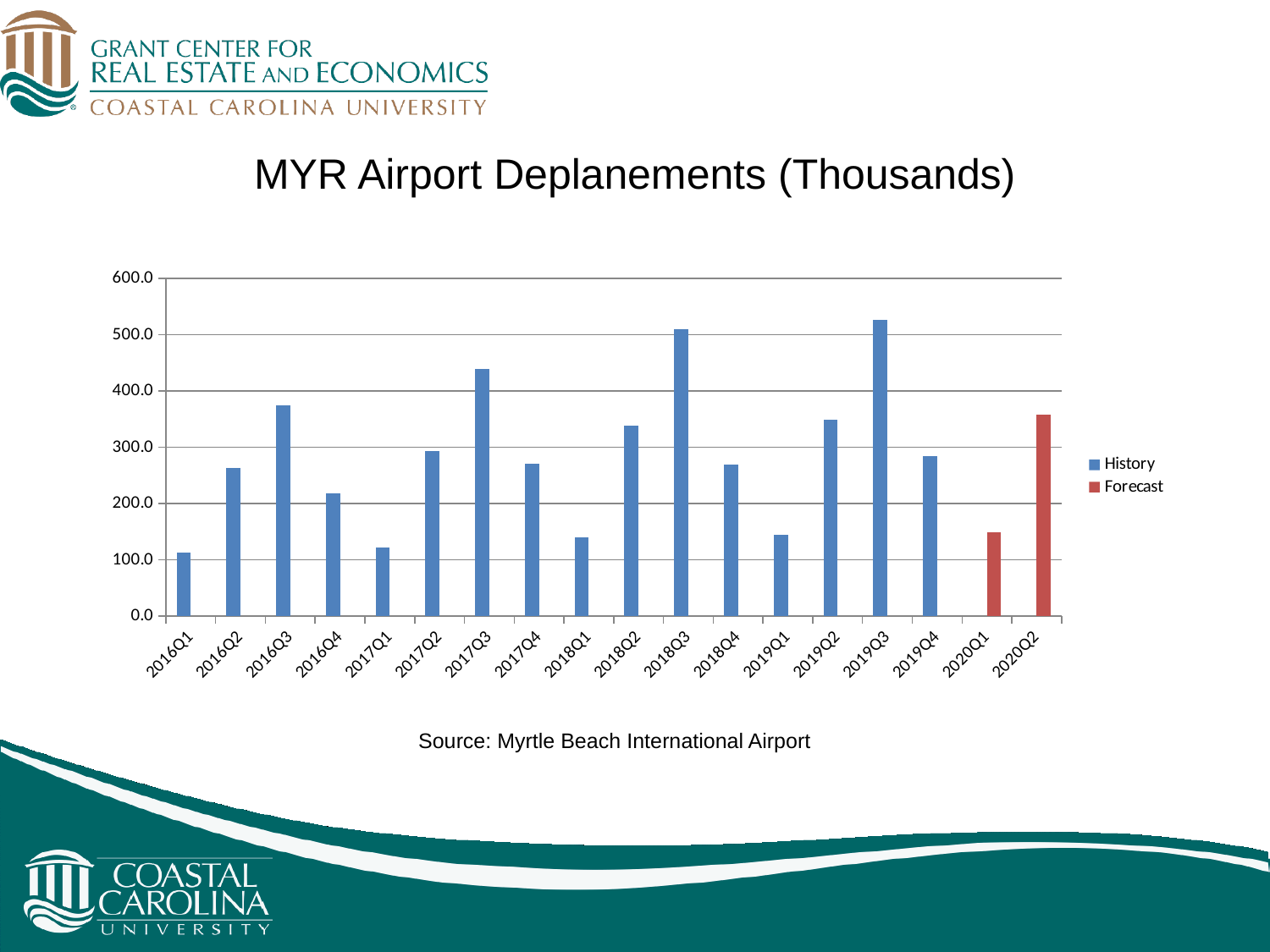
Is the value for 2017Q3 greater or less than 400.0? greater Is the value for 2020Q1 greater or less than 200.0? less What is the title of the chart? MYR Airport Deplanements (Thousands) Which quarter has the highest value? 2019Q3 What kind of chart is shown on the slide? bar chart Which is larger, the value for 2017Q3 or the value for 2016Q3? 2017Q3 How many quarters are shown on the x axis? 18 How many series does the legend list? 2 Is the value for 2020Q2 greater or less than 300.0? greater What are the two series named in the legend? History and Forecast Which is larger, the value for 2018Q2 or the value for 2018Q4? 2018Q2